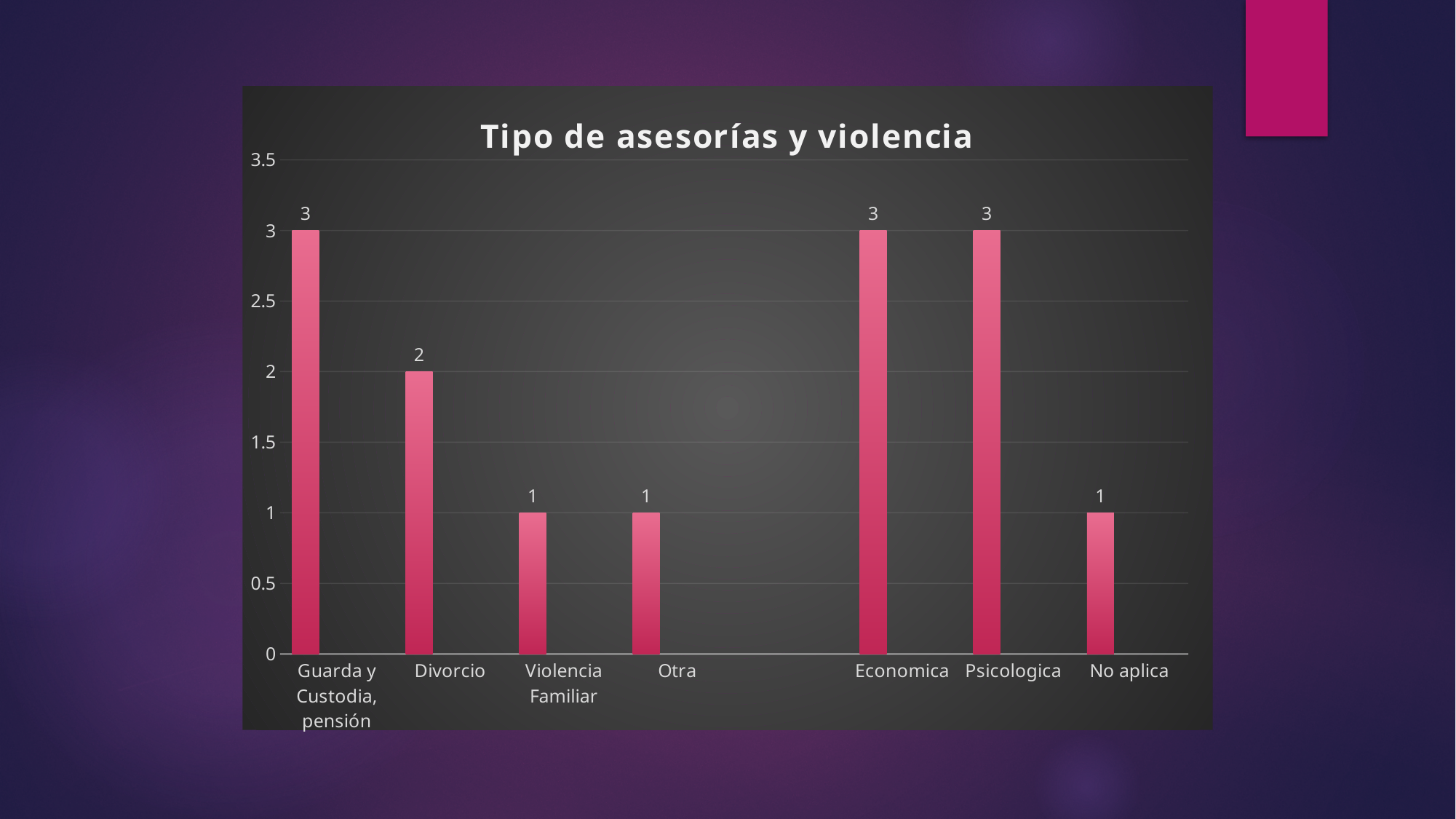
What kind of chart is shown on the slide? bar chart What is the value for No aplica? 1 Which has a larger value, Divorcio or Otra? Divorcio Which has a larger value, Economica or No aplica? Economica How many bars are plotted in the chart? 7 What is the value for Economica? 3 What is the value for Violencia Familiar? 1 What is the difference between the values for Psicologica and No aplica? 2 Is the value for Divorcio greater or less than 1.5? greater What is the value for Divorcio in the chart? 2 What is the difference between the values for Guarda y Custodia, pensión and Divorcio? 1 What is the value for Guarda y Custodia, pensión? 3